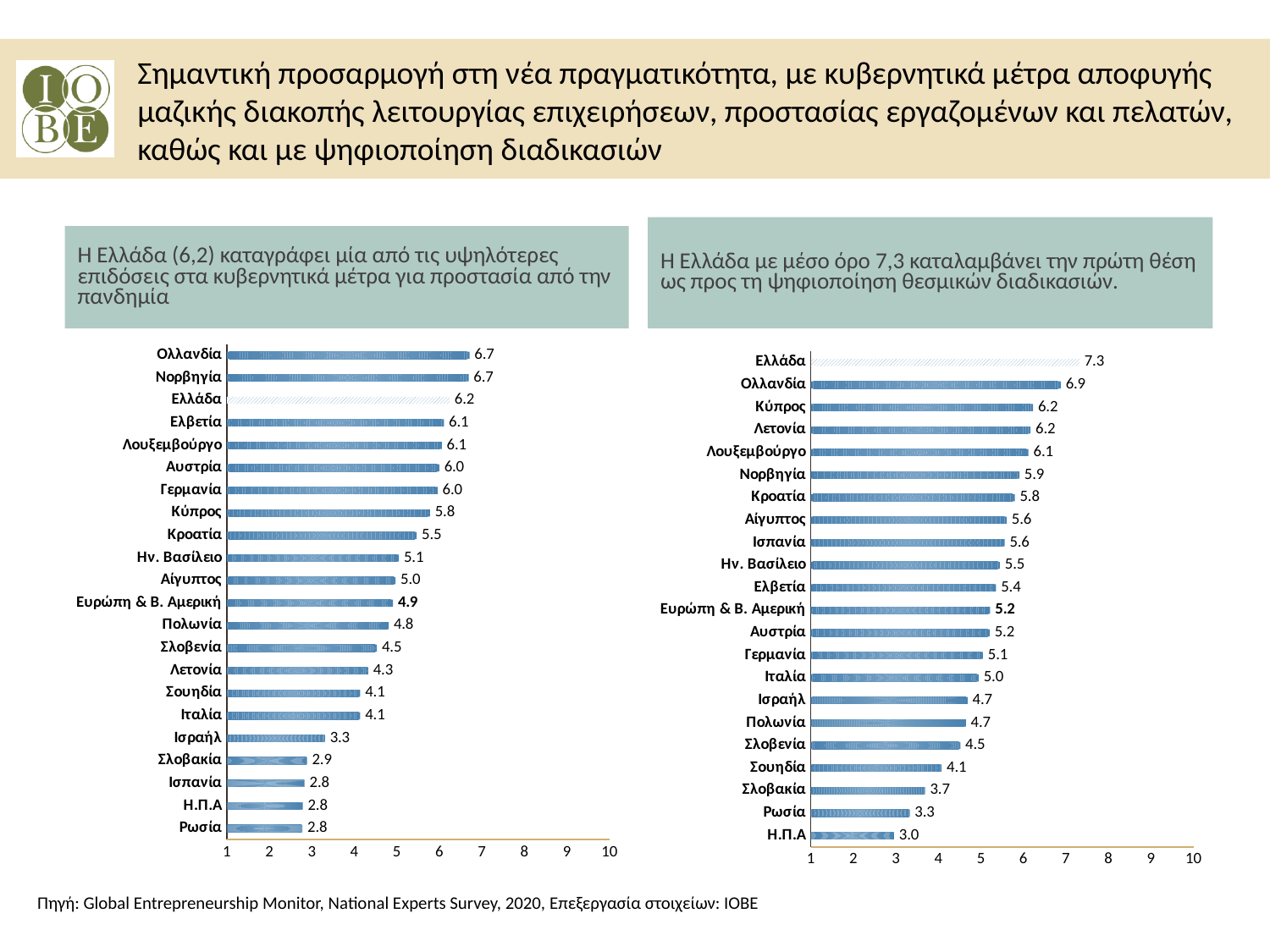
In the right chart, what is the value for Σλοβακία? 3.7 In the right chart, is the value for Ρωσία greater or less than 4? less In the left chart, what is the value for Ελλάδα? 6.2 In the right chart, which category has the lowest value? Η.Π.Α In the left chart, what is the value for Κύπρος? 5.8 What kind of chart is the right chart? Bar chart In the left chart, which is larger, the value for Ισραήλ or the value for Πολωνία? Πολωνία How many categories are shown in the left chart? 22 In the left chart, what is the difference between the values for Ολλανδία and Ρωσία? 3.9 In the right chart, what is the value for Ελλάδα? 7.3 In the right chart, which category has the highest value? Ελλάδα In the right chart, what is the difference between the values for Ελλάδα and Ολλανδία? 0.4